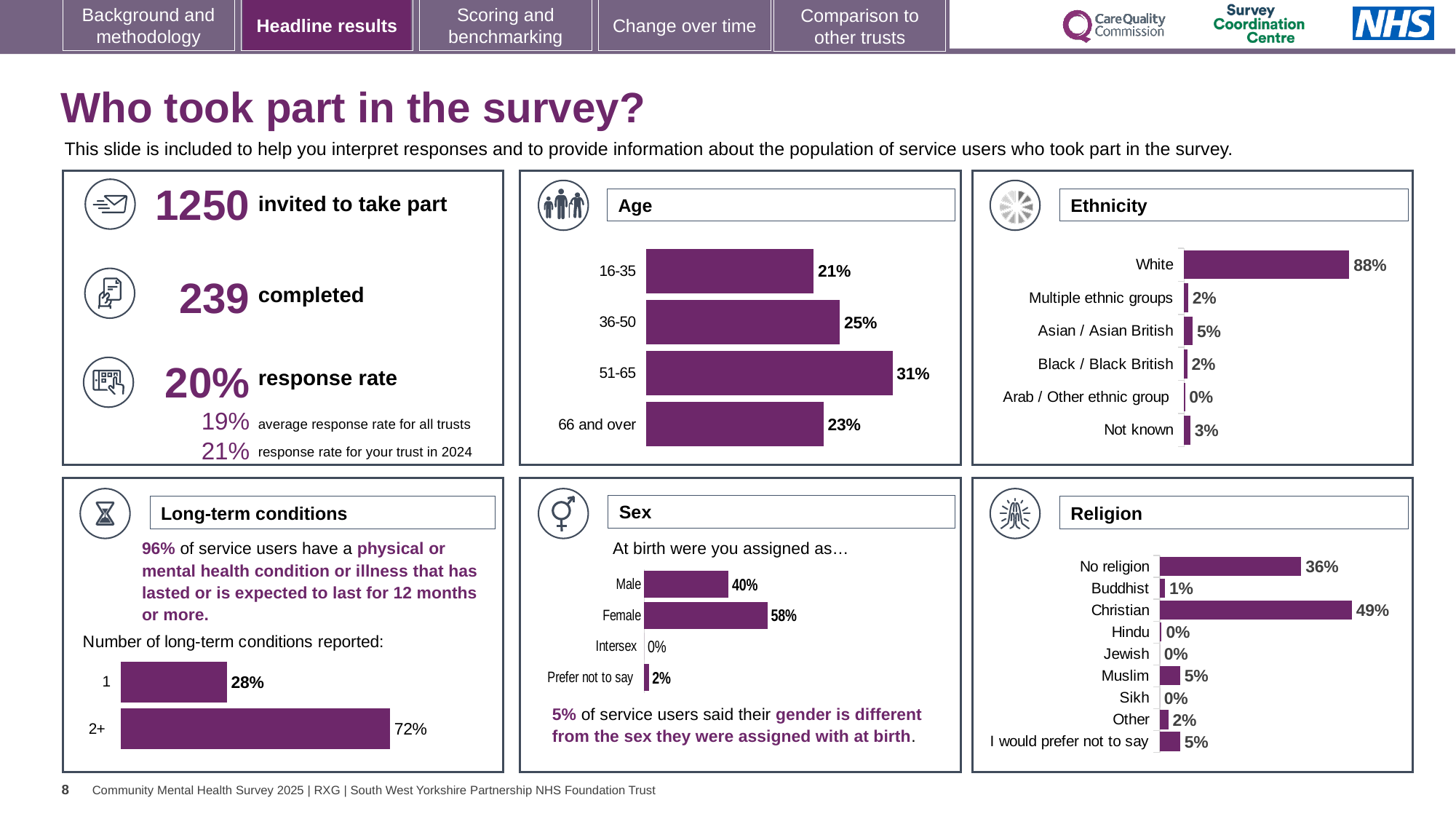
In the Ethnicity chart, what percentage of respondents were White? 88% In the Age chart, what is the difference between the 36-50 and 16-35 percentages? 4% What type of chart is used in the Age panel? Bar chart In the Sex chart, what percentage of respondents were assigned Female at birth? 58% In the Sex chart, what is the difference between the Female and Male percentages? 18% In the Age chart, which age group has the lowest percentage? 16-35 In the Religion chart, which religion category has the highest percentage? Christian In the Ethnicity chart, which is larger: Asian / Asian British or Not known? Asian / Asian British In the Age chart, what percentage of respondents were aged 51-65? 31% In the Religion chart, what percentage of respondents reported No religion? 36% In the Ethnicity chart, how many ethnicity categories are shown? 6 In the Long-term conditions chart, what percentage of respondents reported 2+ long-term conditions? 72%